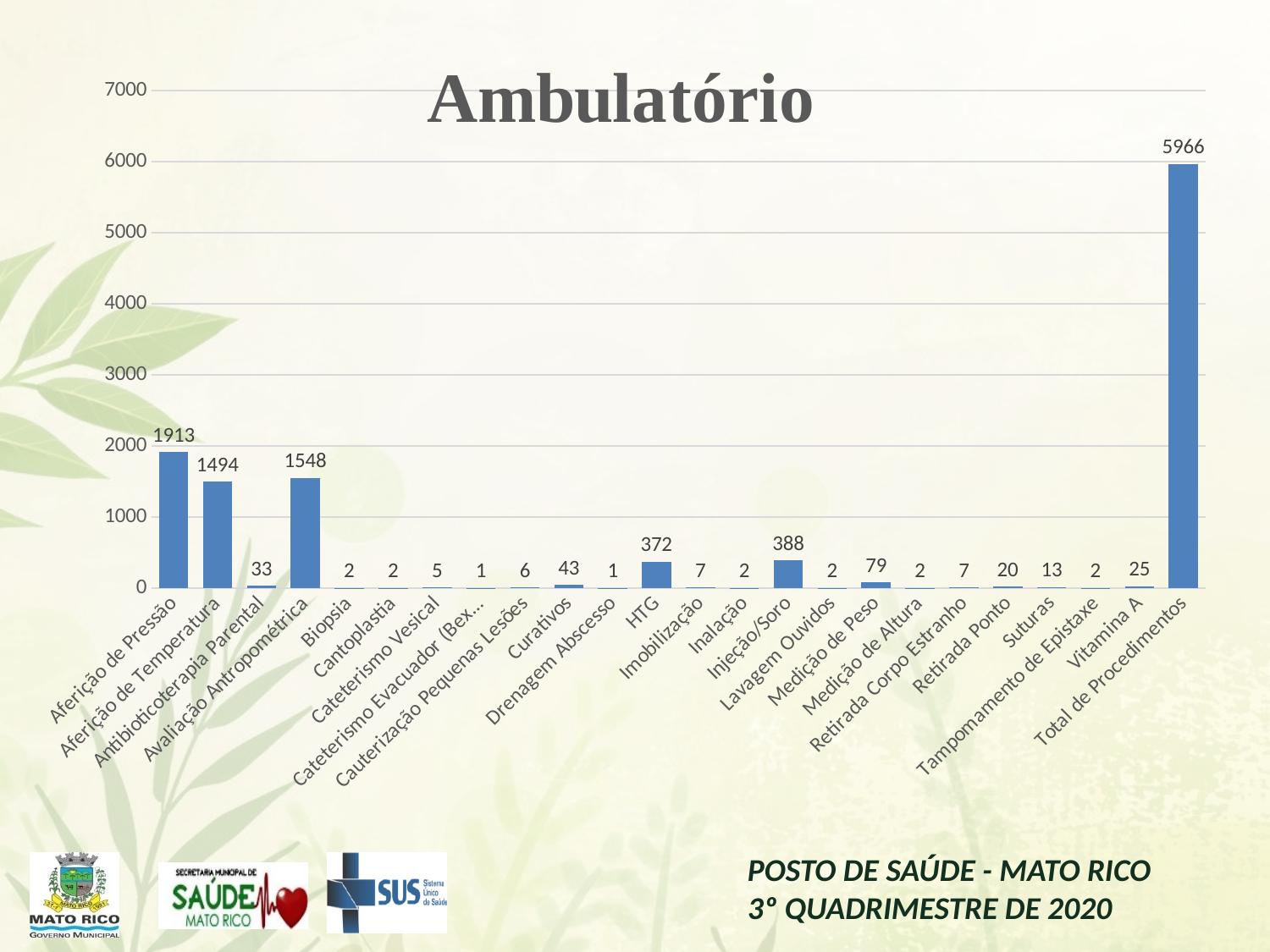
What is the difference between Aferição de Pressão and Aferição de Temperatura? 419 What is the value for Medição de Peso? 79 What is the value for Injeção/Soro? 388 What kind of chart is shown on the slide? Bar chart How many categories are shown on the x axis? 24 Which category has the highest value? Total de Procedimentos What is the value for Total de Procedimentos? 5966 What is the value for Aferição de Pressão? 1913 What is the value for Avaliação Antropométrica? 1548 What is the title of the chart? Ambulatório Is the value for Total de Procedimentos greater or less than 5000? greater Which is larger, HTG or Injeção/Soro? Injeção/Soro